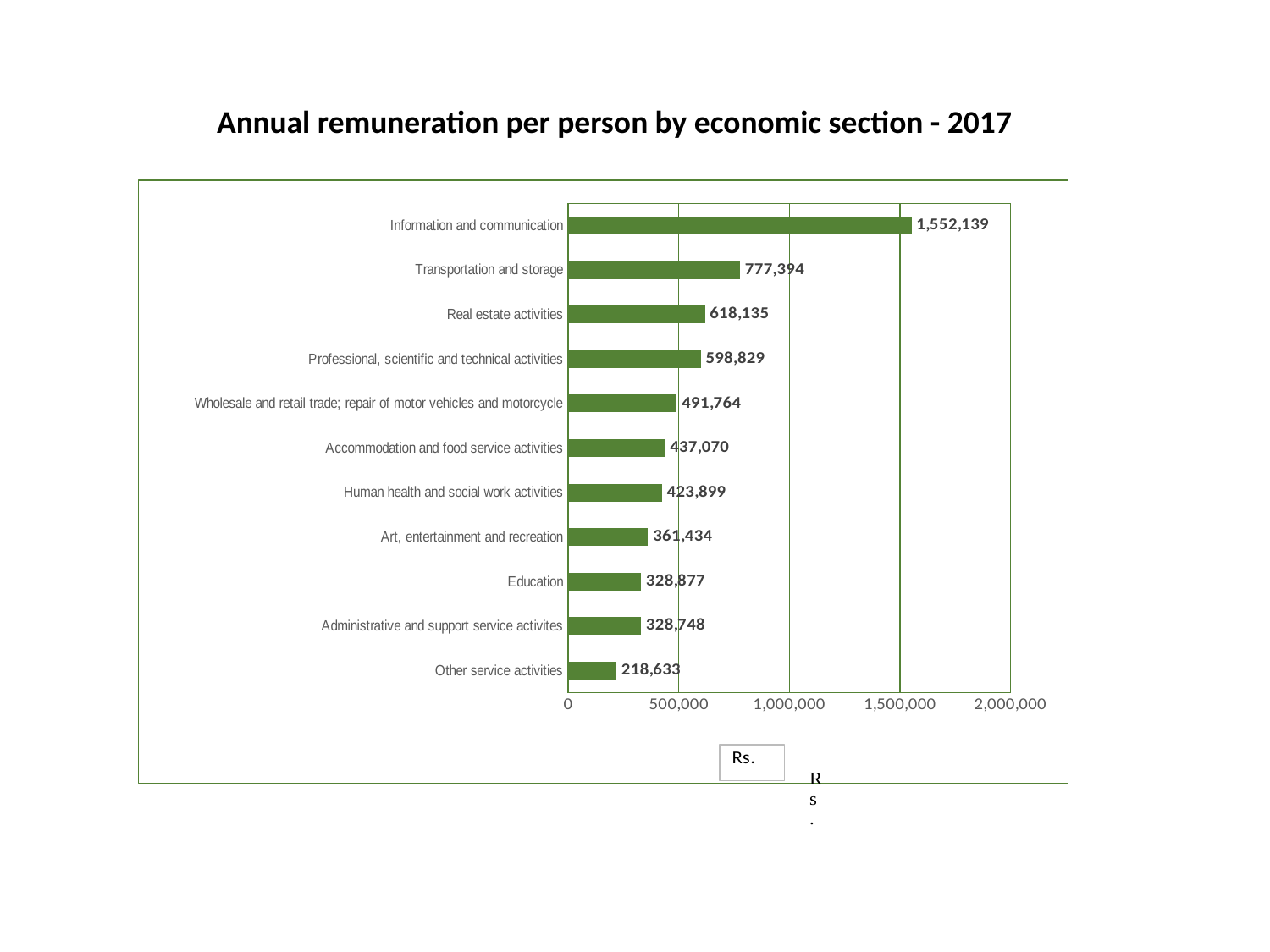
How many economic sections are shown in the chart? 11 Which is larger, the value for Accommodation and food service activities or the value for Human health and social work activities? Accommodation and food service activities What kind of chart is shown on the slide? bar chart What is the annual remuneration per person for Information and communication? 1,552,139 What is the difference between the values for Transportation and storage and Real estate activities? 159,259 What is the difference between the values for Education and Administrative and support service activites? 129 Which economic section has the lowest annual remuneration per person? Other service activities Which economic section has the highest annual remuneration per person? Information and communication What is the value shown for Education? 328,877 What is the title of the chart? Annual remuneration per person by economic section - 2017 Is the value for Transportation and storage greater or less than 1,000,000? less What is the value shown for Real estate activities? 618,135